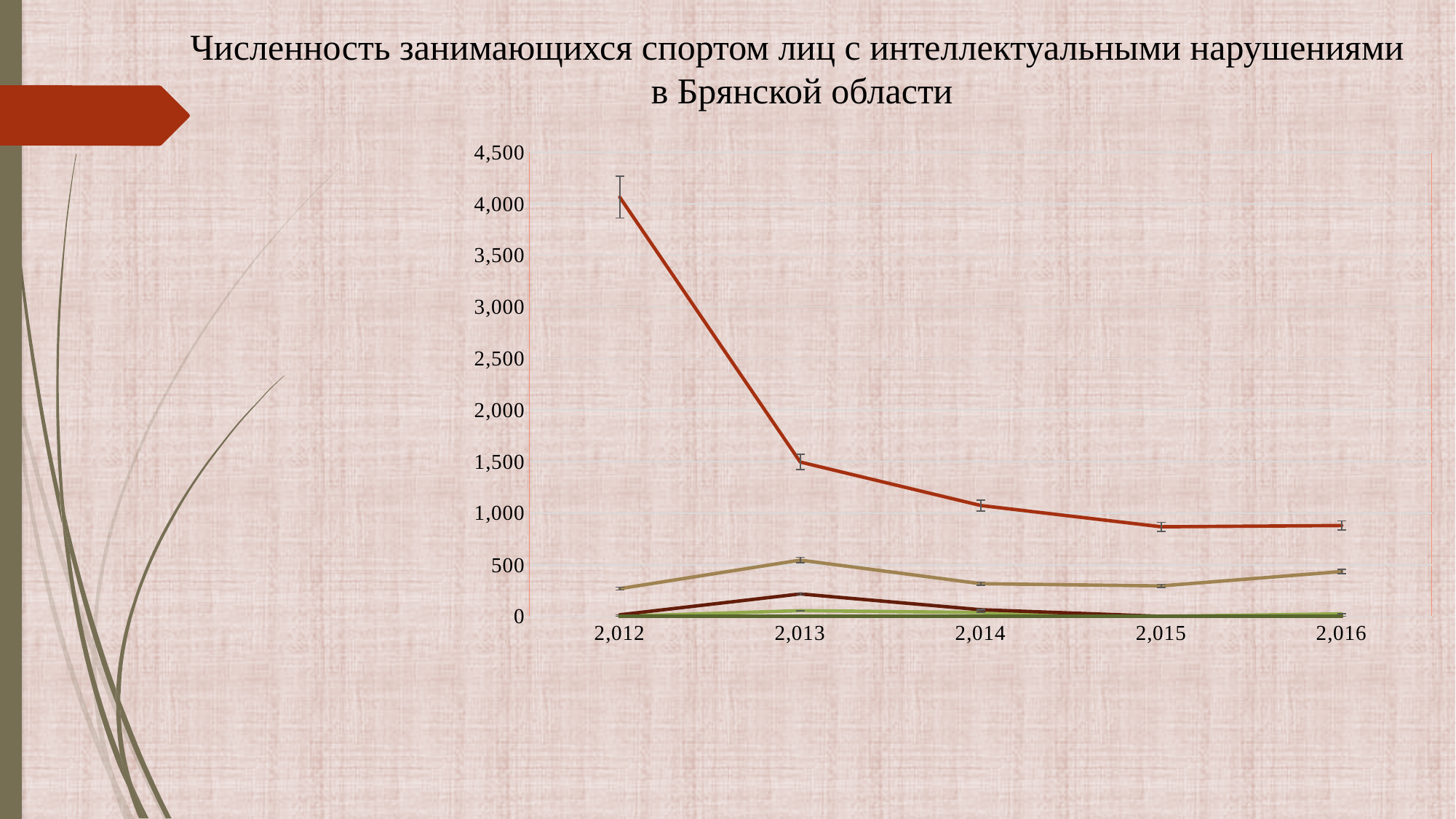
Which year has the highest value on the tan (light brown) line? 2,013 What is the title of the chart? Численность занимающихся спортом лиц с интеллектуальными нарушениями в Брянской области Which year has the highest value on the red line? 2,012 What kind of chart is shown on the slide? line chart Does the red line rise or fall from 2,012 to 2,015? fall How many years are shown along the x axis of the chart? 5 Is the value of the red line in 2,013 greater or less than 1,000? greater Which is larger on the red line: the value in 2,012 or the value in 2,013? 2,012 Is the value of the tan (light brown) line in 2,012 greater or less than 500? less What is the highest value shown on the y axis of the chart? 4,500 Is the value of the red line in 2,012 greater or less than 3,500? greater